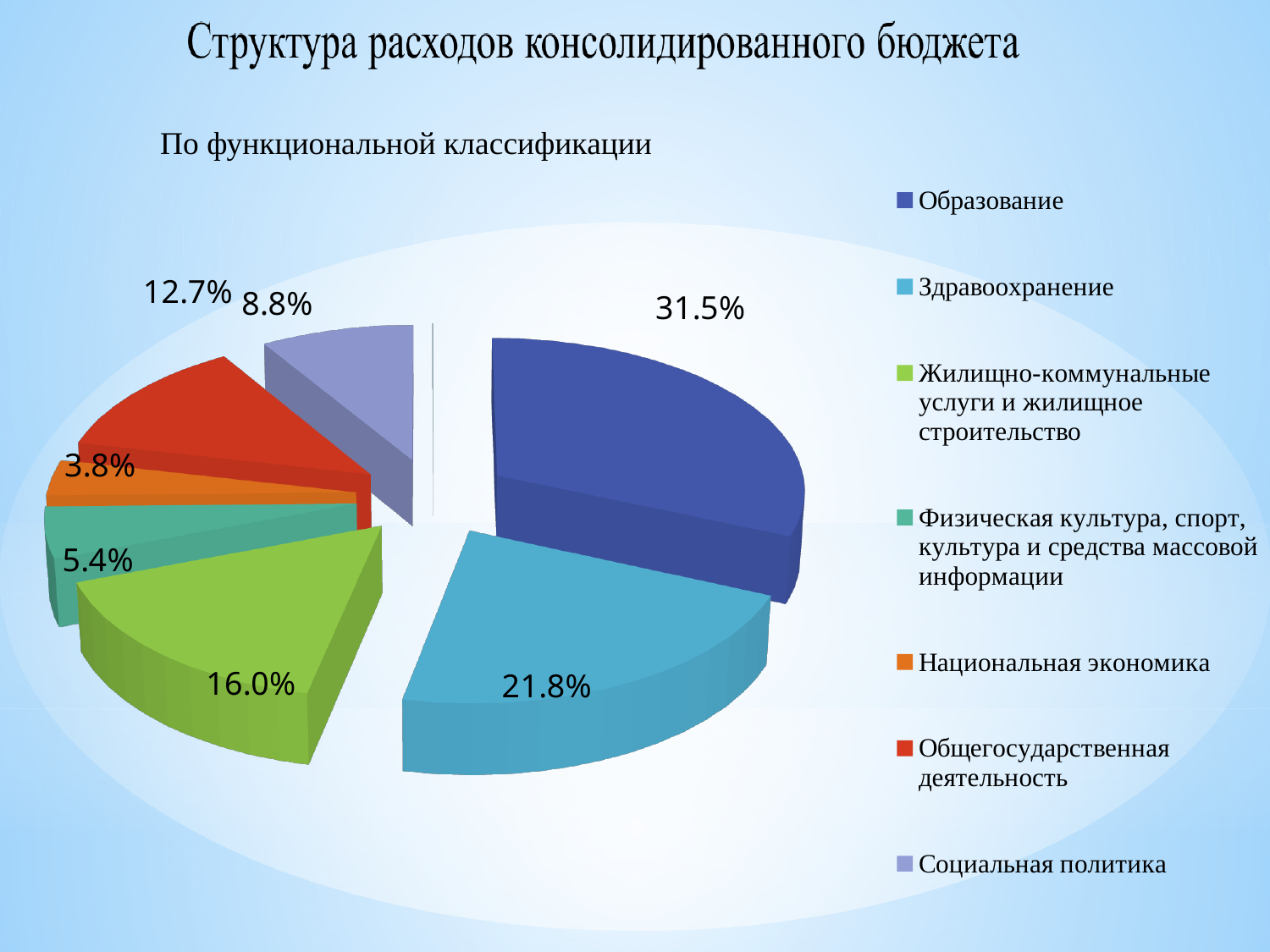
What share of the pie does Образование have? 31.5% What is the value for Национальная экономика? 3.8% Which category has the largest slice of the pie? Образование What is the title of the chart? Структура расходов консолидированного бюджета Which is larger, the share of Общегосударственная деятельность or the share of Социальная политика? Общегосударственная деятельность How many categories does the legend list? 7 Which category has the smallest slice of the pie? Национальная экономика What is the difference between the shares of Образование and Здравоохранение? 9.7% What is the value for Социальная политика? 8.8% What is the value for Жилищно-коммунальные услуги и жилищное строительство? 16.0% What kind of chart is shown on the slide? pie chart What is the value for Здравоохранение? 21.8%